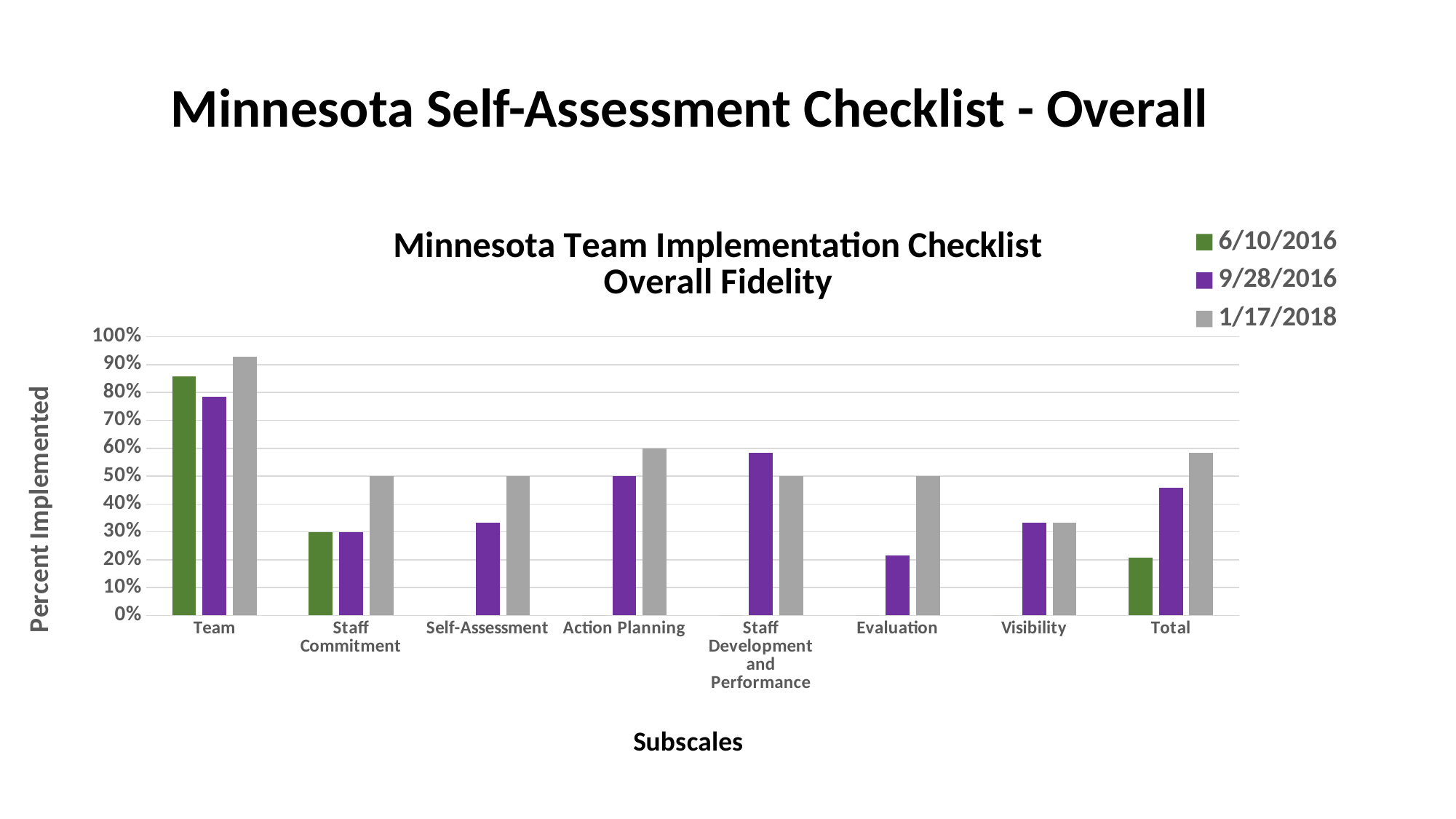
Is the 6/10/2016 value for Team greater or less than 80%? greater What is the title of the chart? Minnesota Team Implementation Checklist Overall Fidelity Which subscale has the lowest value for the 9/28/2016 series? Evaluation For Staff Development and Performance, which series has the larger value: 9/28/2016 or 1/17/2018? 9/28/2016 What kind of chart is shown on the slide? bar chart What is the title of the y axis? Percent Implemented What is the 1/17/2018 value for Action Planning? 60% For Team, which series has the larger value: 9/28/2016 or 1/17/2018? 1/17/2018 How many subscale categories are shown on the x axis? 8 Is the 6/10/2016 value for Total greater or less than 30%? less Which subscale has the highest value for the 1/17/2018 series? Team How many series does the legend list? 3